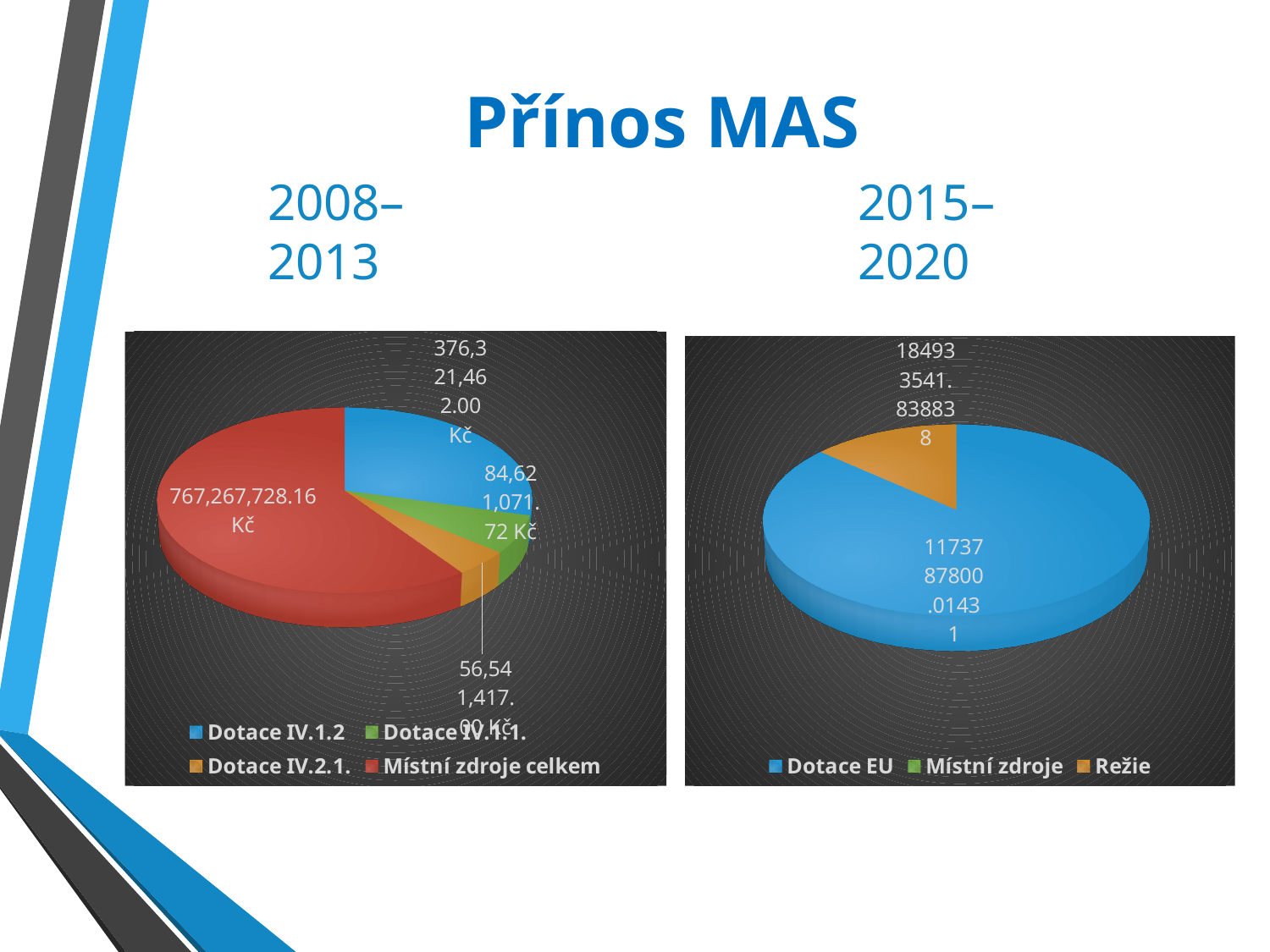
How many categories does the legend of the 2008–2013 chart list? 4 In the 2008–2013 chart, what is the value for Dotace IV.1.2? 376,321,462.00 Kč In the 2008–2013 chart, which is larger, Dotace IV.1.2 or Dotace IV.1.1.? Dotace IV.1.2 In the 2008–2013 chart, which category has the smallest slice? Dotace IV.2.1. How many categories does the legend of the 2015–2020 chart list? 3 In the 2015–2020 chart, which category has the largest slice? Dotace EU In the 2008–2013 chart, what is the value for Dotace IV.1.1.? 84,621,071.72 Kč What kind of chart is the 2008–2013 chart on the left? pie chart In the 2008–2013 chart, what is the difference between Místní zdroje celkem and Dotace IV.1.2? 390,946,266.16 Kč What kind of chart is the 2015–2020 chart on the right? pie chart In the 2008–2013 chart, which category has the largest slice? Místní zdroje celkem In the 2008–2013 chart, what is the value for Místní zdroje celkem? 767,267,728.16 Kč